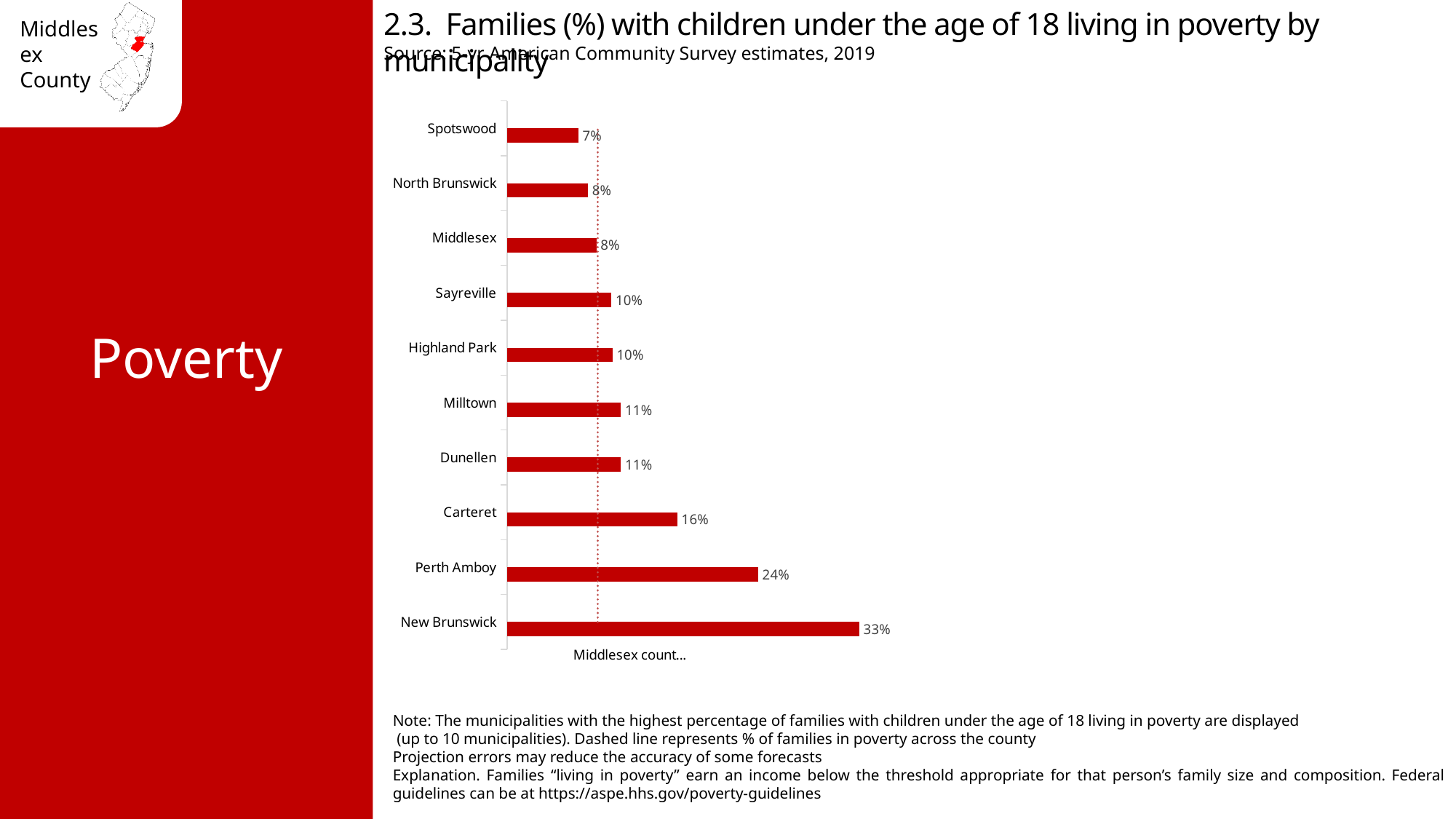
What is the difference between the values for New Brunswick and Perth Amboy? 9% Which municipality has the lowest percentage shown on the chart? Spotswood What is the difference between the values for Carteret and Sayreville? 6% What kind of chart is shown on the slide? Bar chart Which is larger, the value for Perth Amboy or the value for Carteret? Perth Amboy What is the value for Perth Amboy? 24% What is the value for New Brunswick? 33% Which municipality has the highest percentage of families with children under 18 living in poverty? New Brunswick What is the value for Spotswood? 7% What does the dashed vertical line on the chart represent? % of families in poverty across the county How many municipalities are shown on the chart? 10 What is the value for Carteret? 16%